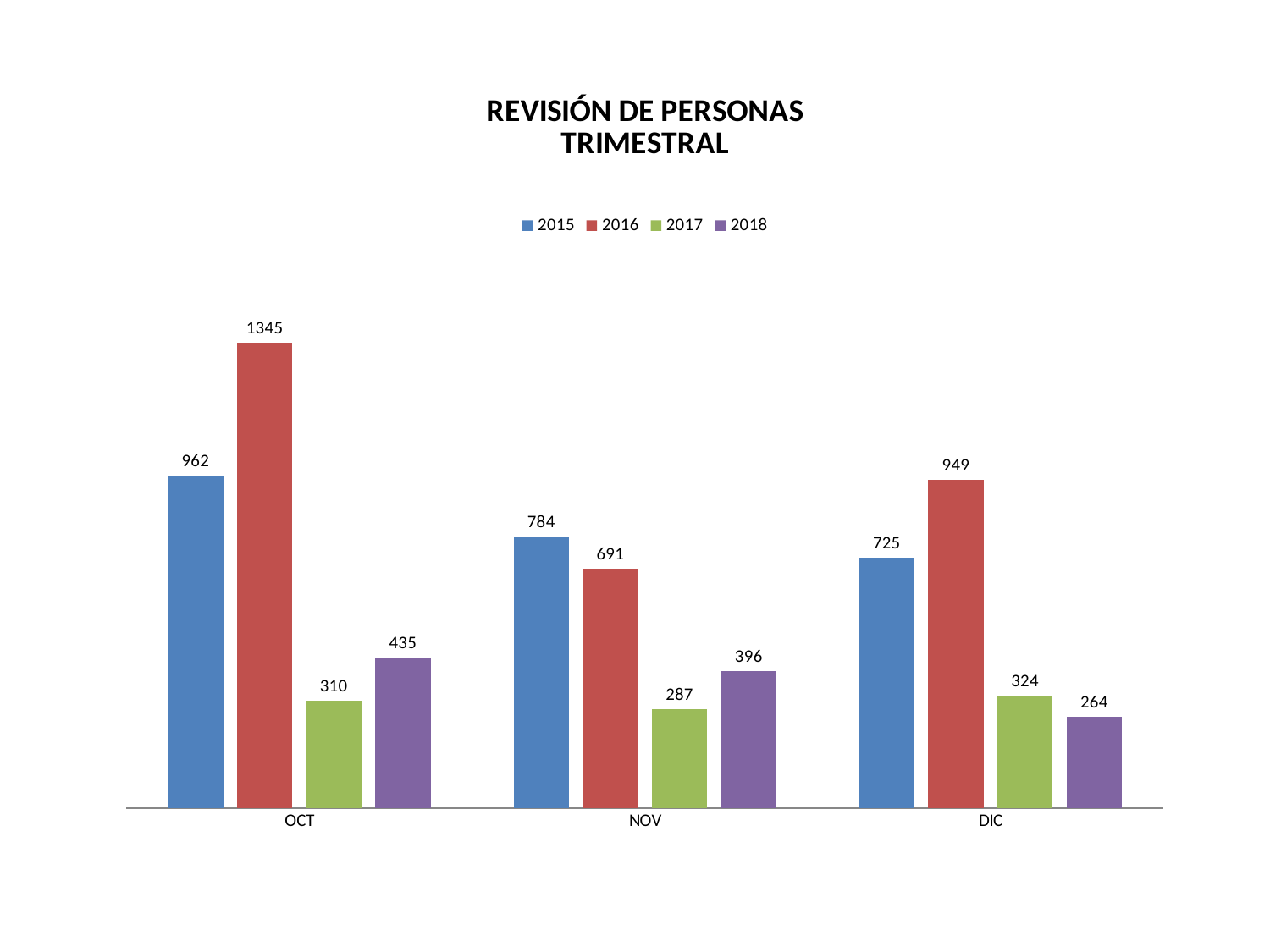
What is the title of the chart? REVISIÓN DE PERSONAS TRIMESTRAL How many months are shown on the x axis? 3 What is the difference between the 2016 and 2015 values in OCT? 383 Which is larger in NOV: the value for 2015 or the value for 2016? 2015 What is the value for 2018 in DIC? 264 What kind of chart is shown on the slide? Bar chart What is the value for 2016 in OCT? 1345 What is the value for 2017 in NOV? 287 How many series does the legend list? 4 Which month has the highest value for 2015? OCT Do the values for 2015 rise or fall from OCT to DIC? Fall Which month has the lowest value for 2018? DIC